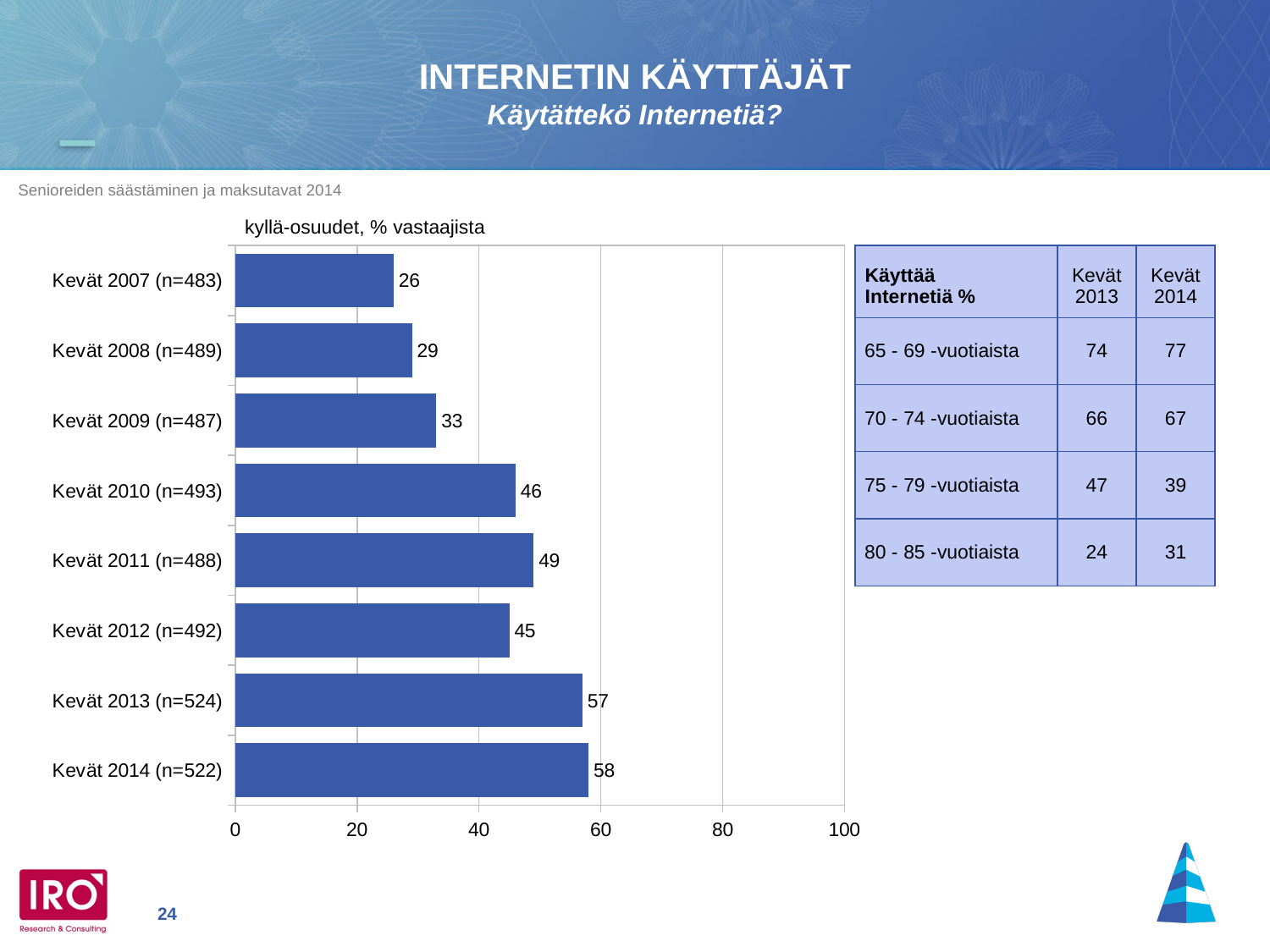
What is the label shown above the chart describing the plotted values? kyllä-osuudet, % vastaajista What is the value for Kevät 2011 (n=488)? 49 Do the values generally rise or fall from Kevät 2007 to Kevät 2014? rise Which category has the lowest value? Kevät 2007 (n=483) How many categories are shown in the chart? 8 What is the value for Kevät 2014 (n=522)? 58 Which is larger, the value for Kevät 2011 (n=488) or Kevät 2012 (n=492)? Kevät 2011 (n=488) What kind of chart is shown on the slide? bar chart What is the difference between the values for Kevät 2014 (n=522) and Kevät 2007 (n=483)? 32 Is the value for Kevät 2010 (n=493) greater or less than 40? greater Which category has the highest value? Kevät 2014 (n=522) What is the value for Kevät 2007 (n=483)? 26